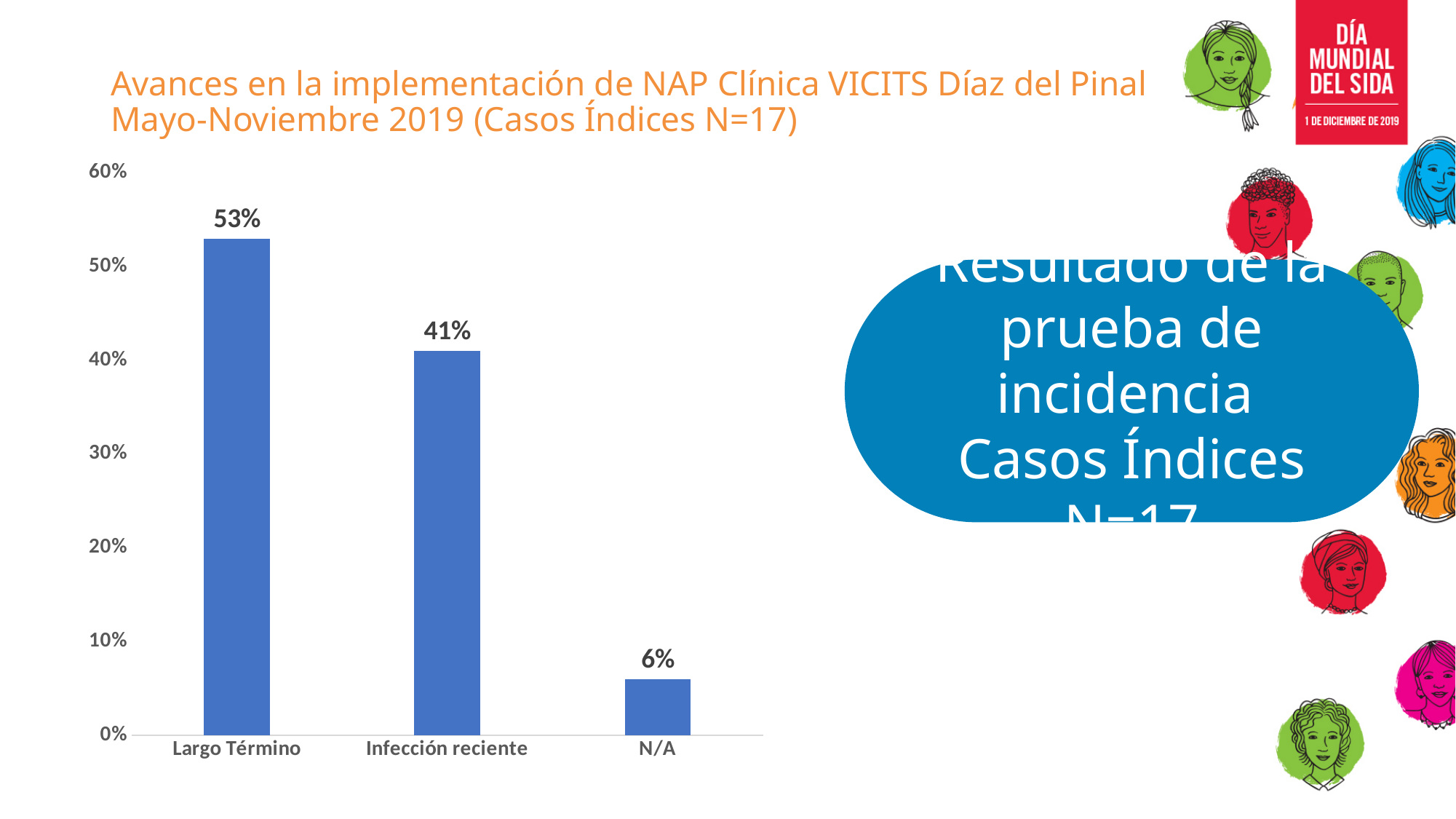
Is the value for Infección reciente greater or less than 50%? less What kind of chart is shown? bar chart What is the value for N/A? 6% Which is larger, Largo Término or Infección reciente? Largo Término What is the value for Largo Término? 53% Which category has the lowest value? N/A How many categories are shown on the x axis? 3 What is the value for Infección reciente? 41% What is the difference between Largo Término and Infección reciente? 12% What is the difference between Infección reciente and N/A? 35% Which category has the highest value? Largo Término Do the values rise or fall from left to right along the x axis? fall